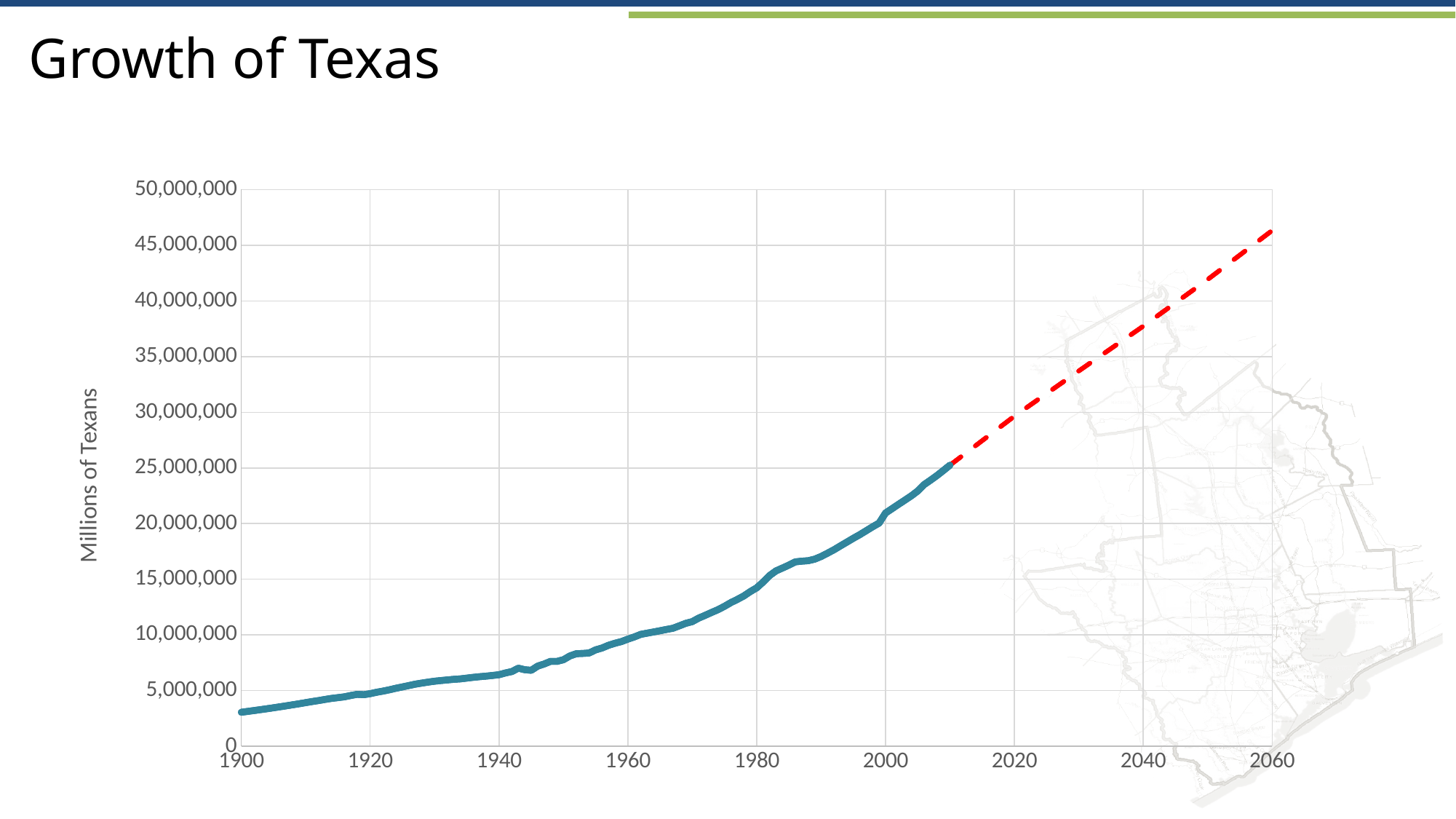
Is the value for 2040 greater or less than 35,000,000? greater Is the value for 2020 greater or less than 25,000,000? greater Is the value for 1980 greater or less than 15,000,000? less What is the label on the vertical axis of the chart? Millions of Texans Do the values rise or fall along the x axis from 1900 to 2060? rise Which year has the higher value, 1920 or 1960? 1960 What kind of chart is shown on the slide? line chart What is the title of the chart? Growth of Texas